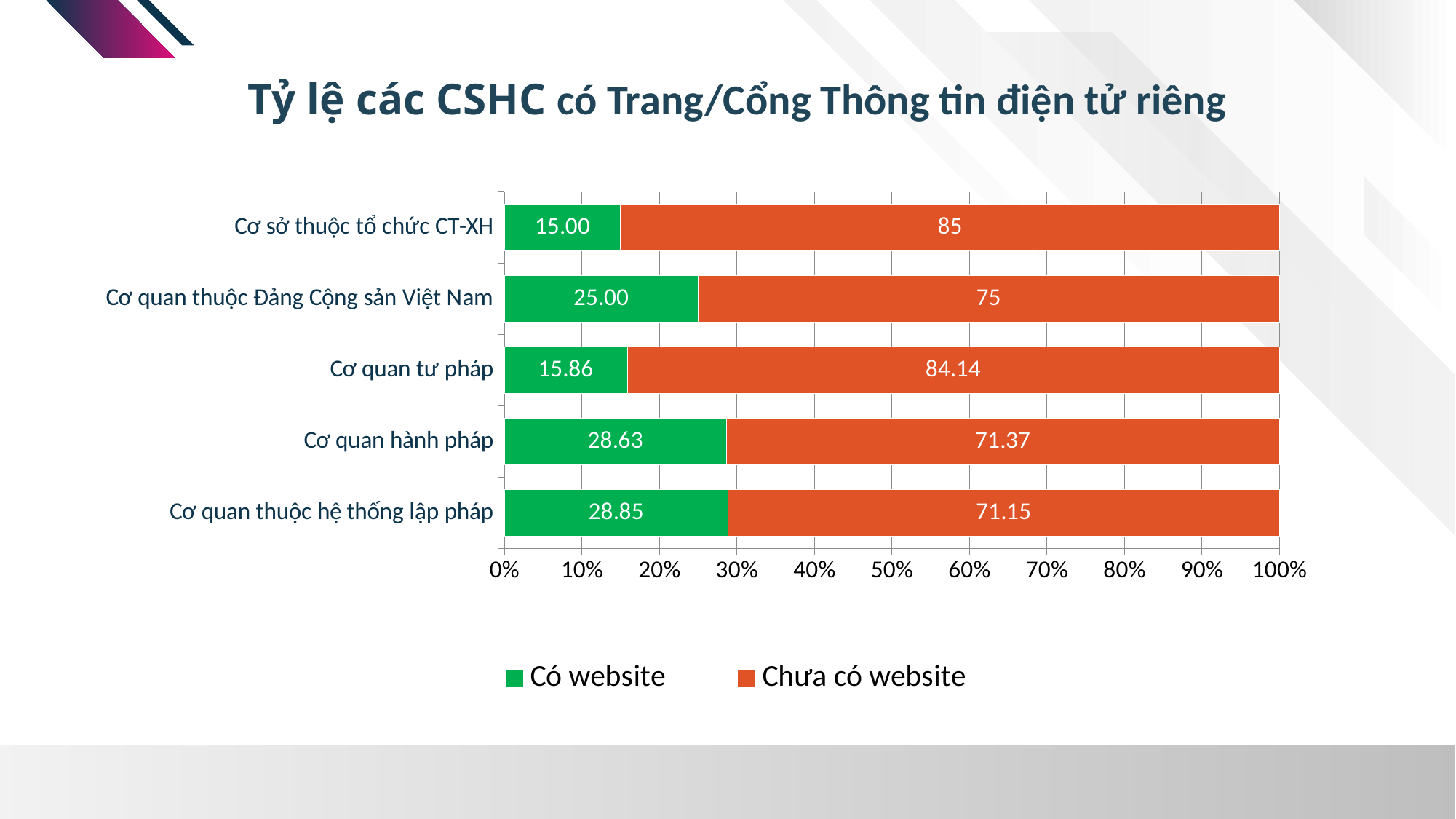
What is the value of "Chưa có website" for Cơ quan tư pháp? 84.14 Which has the larger "Có website" value: Cơ quan thuộc Đảng Cộng sản Việt Nam or Cơ quan tư pháp? Cơ quan thuộc Đảng Cộng sản Việt Nam What is the difference between "Chưa có website" and "Có website" for Cơ quan hành pháp? 42.74 What is the value of "Có website" for Cơ quan thuộc hệ thống lập pháp? 28.85 What is the value of "Có website" for Cơ quan hành pháp? 28.63 How many series does the legend list? 2 What kind of chart is shown on the slide? Stacked bar chart What is the value of "Có website" for Cơ quan thuộc Đảng Cộng sản Việt Nam? 25.00 What is the value of "Chưa có website" for Cơ sở thuộc tổ chức CT-XH? 85 How many categories are shown on the chart? 5 Is the "Có website" value for Cơ quan hành pháp greater or less than 30%? less What is the difference between "Chưa có website" and "Có website" for Cơ quan thuộc Đảng Cộng sản Việt Nam? 50